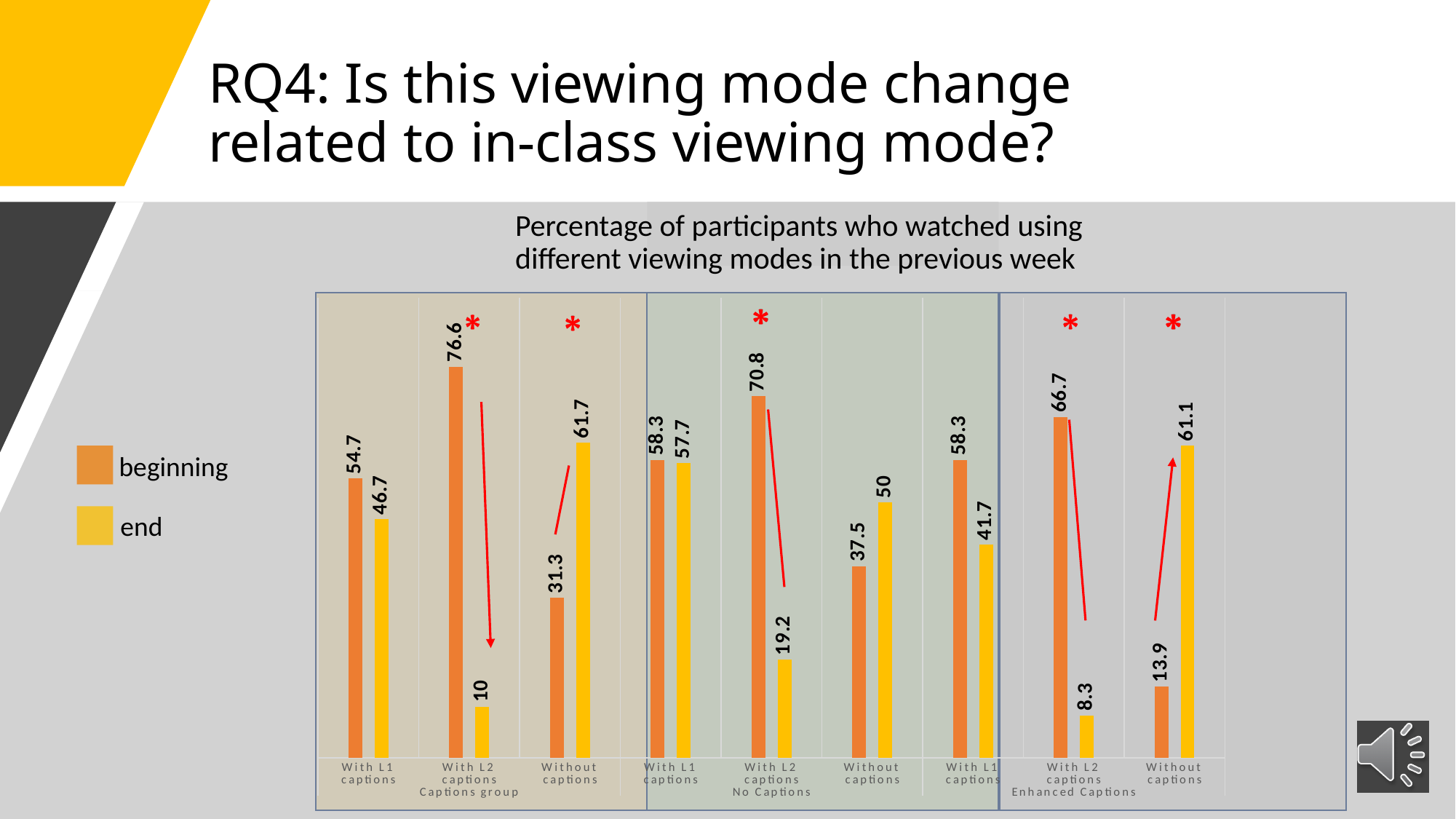
For 'Without captions' in the No Captions group, which is larger, the 'beginning' or the 'end' value? end What type of chart is shown on the slide? bar chart What is the difference between the 'beginning' and 'end' values for 'With L2 captions' in the Captions group? 66.6 Which category in the Enhanced Captions group has the lowest 'end' value? With L2 captions What is the difference between the 'end' and 'beginning' values for 'Without captions' in the Enhanced Captions group? 47.2 What is the title of the chart? Percentage of participants who watched using different viewing modes in the previous week What is the 'beginning' value for 'Without captions' in the No Captions group? 37.5 What is the 'beginning' value for 'With L2 captions' in the Captions group? 76.6 What is the 'end' value for 'With L2 captions' in the No Captions group? 19.2 Which category across the whole chart has the highest 'beginning' value? With L2 captions (Captions group) What is the 'end' value for 'Without captions' in the Enhanced Captions group? 61.1 How many series does the legend list? 2